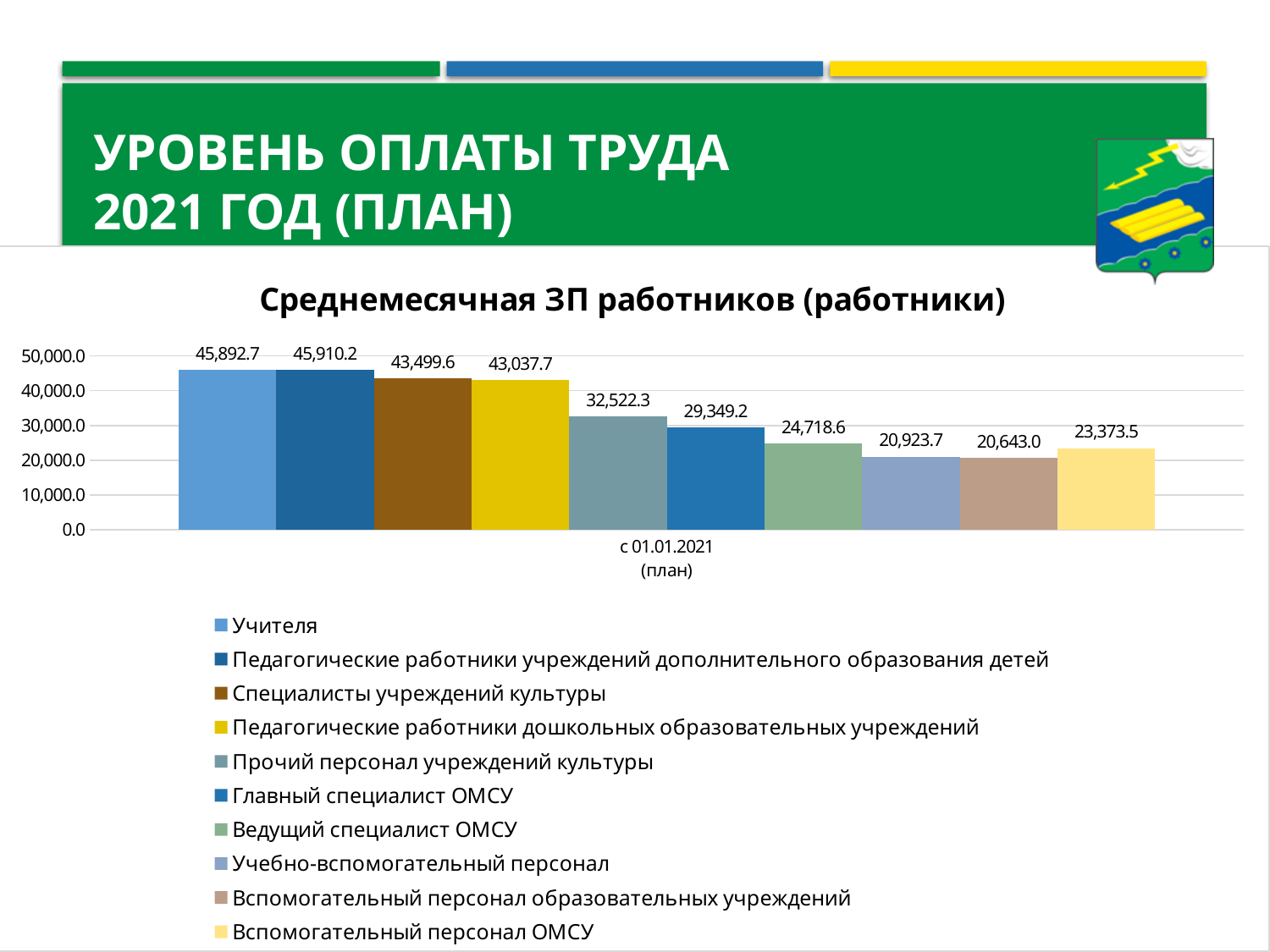
Which series has the highest value? Педагогические работники учреждений дополнительного образования детей What is the difference between the values for Прочий персонал учреждений культуры and Ведущий специалист ОМСУ? 7,803.7 Is the value for Педагогические работники дошкольных образовательных учреждений greater or less than 40,000.0? greater Which is larger, the value for Учебно-вспомогательный персонал or the value for Вспомогательный персонал ОМСУ? Вспомогательный персонал ОМСУ Which series has the lowest value? Вспомогательный персонал образовательных учреждений What is the title of the chart? Среднемесячная ЗП работников (работники) What kind of chart is shown on the slide? bar chart What is the value for Учителя? 45,892.7 What is the value for Главный специалист ОМСУ? 29,349.2 What is the value for Специалисты учреждений культуры? 43,499.6 What is the value for Вспомогательный персонал ОМСУ? 23,373.5 How many series does the legend list? 10